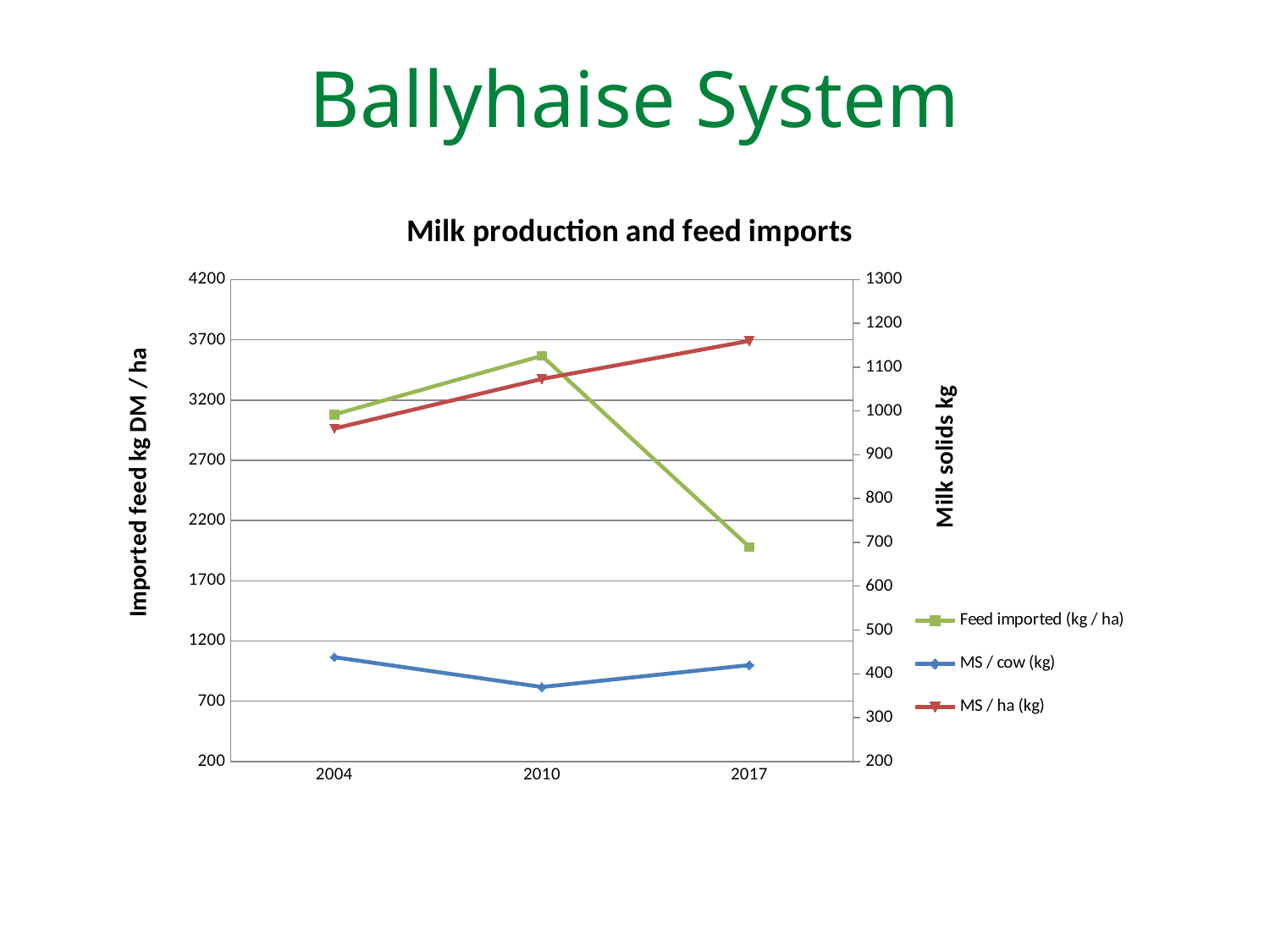
What is the title of the chart? Milk production and feed imports Is the value for Feed imported (kg / ha) in 2010 greater or less than 3200? greater In which year is Feed imported (kg / ha) highest? 2010 How many years are plotted along the x axis? 3 Is the value for Feed imported (kg / ha) in 2017 greater or less than 2200? less In which year is MS / cow (kg) lowest? 2010 What kind of chart is shown on the slide? line chart Which is larger for MS / cow (kg): the value in 2004 or the value in 2010? 2004 Does MS / ha (kg) rise or fall from 2004 to 2017? rise How many series does the legend list? 3 In which year is Feed imported (kg / ha) lowest? 2017 Is the value for MS / ha (kg) in 2017 greater or less than 1100? greater